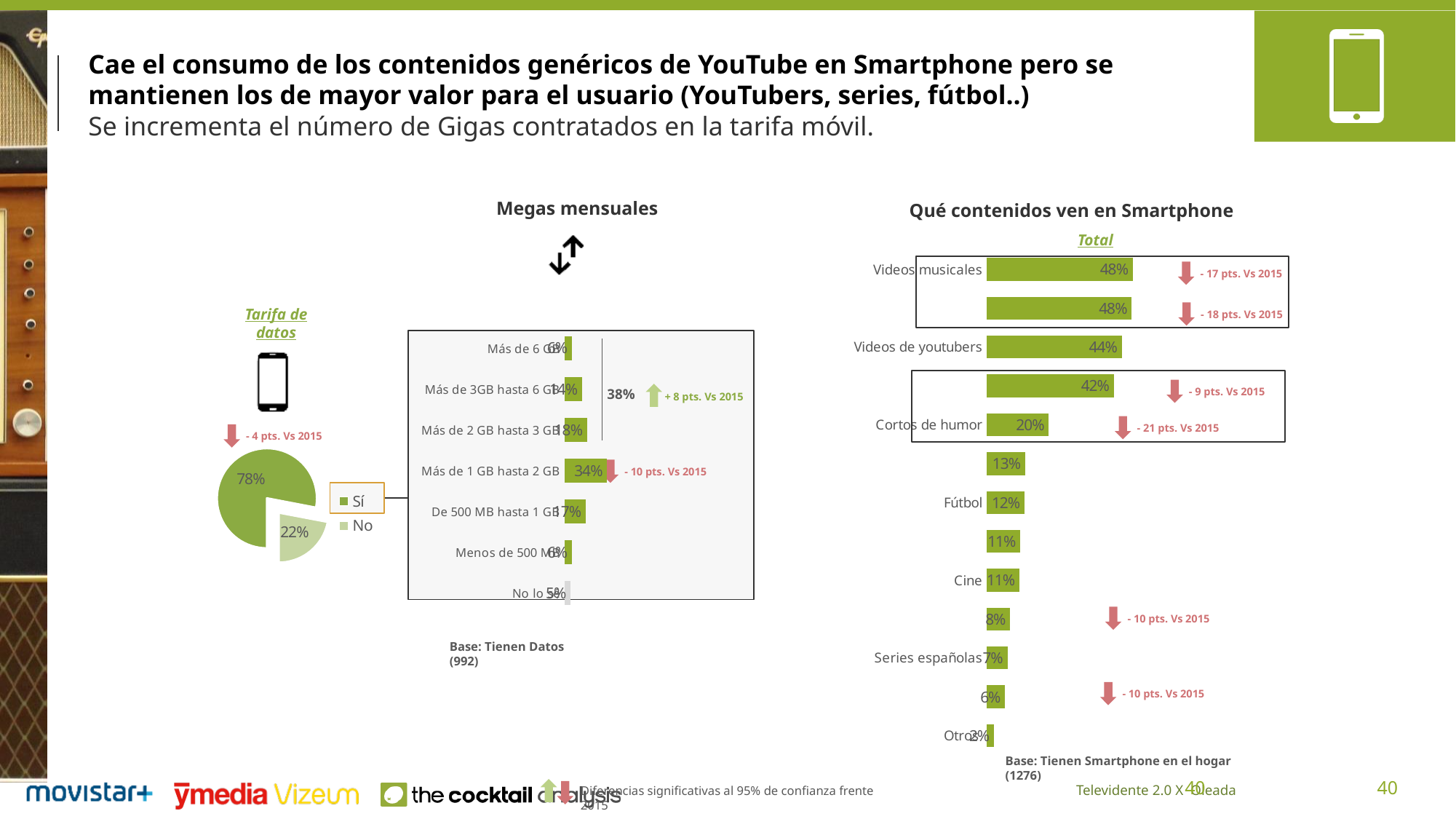
In the 'Tarifa de datos' pie chart, what percentage is shown for 'No'? 22% In the 'Qué contenidos ven en Smartphone' chart, what is the value for 'Cortos de humor'? 20% What kind of chart is the 'Megas mensuales' chart? Bar chart In the 'Qué contenidos ven en Smartphone' chart, what is the value for 'Videos de youtubers'? 44% How many categories are shown in the 'Megas mensuales' chart? 7 In the 'Tarifa de datos' pie chart, what percentage is shown for 'Sí'? 78% In the 'Megas mensuales' chart, which category has the highest value? Más de 1 GB hasta 2 GB What kind of chart is the 'Tarifa de datos' chart? Pie chart In the 'Qué contenidos ven en Smartphone' chart, which category has the lowest value? Otros In the 'Tarifa de datos' pie chart, what is the difference between the 'Sí' and 'No' shares? 56 percentage points In the 'Megas mensuales' chart, what is the value for 'Más de 1 GB hasta 2 GB'? 34% In the 'Qué contenidos ven en Smartphone' chart, which is larger: 'Fútbol' or 'Series españolas'? Fútbol